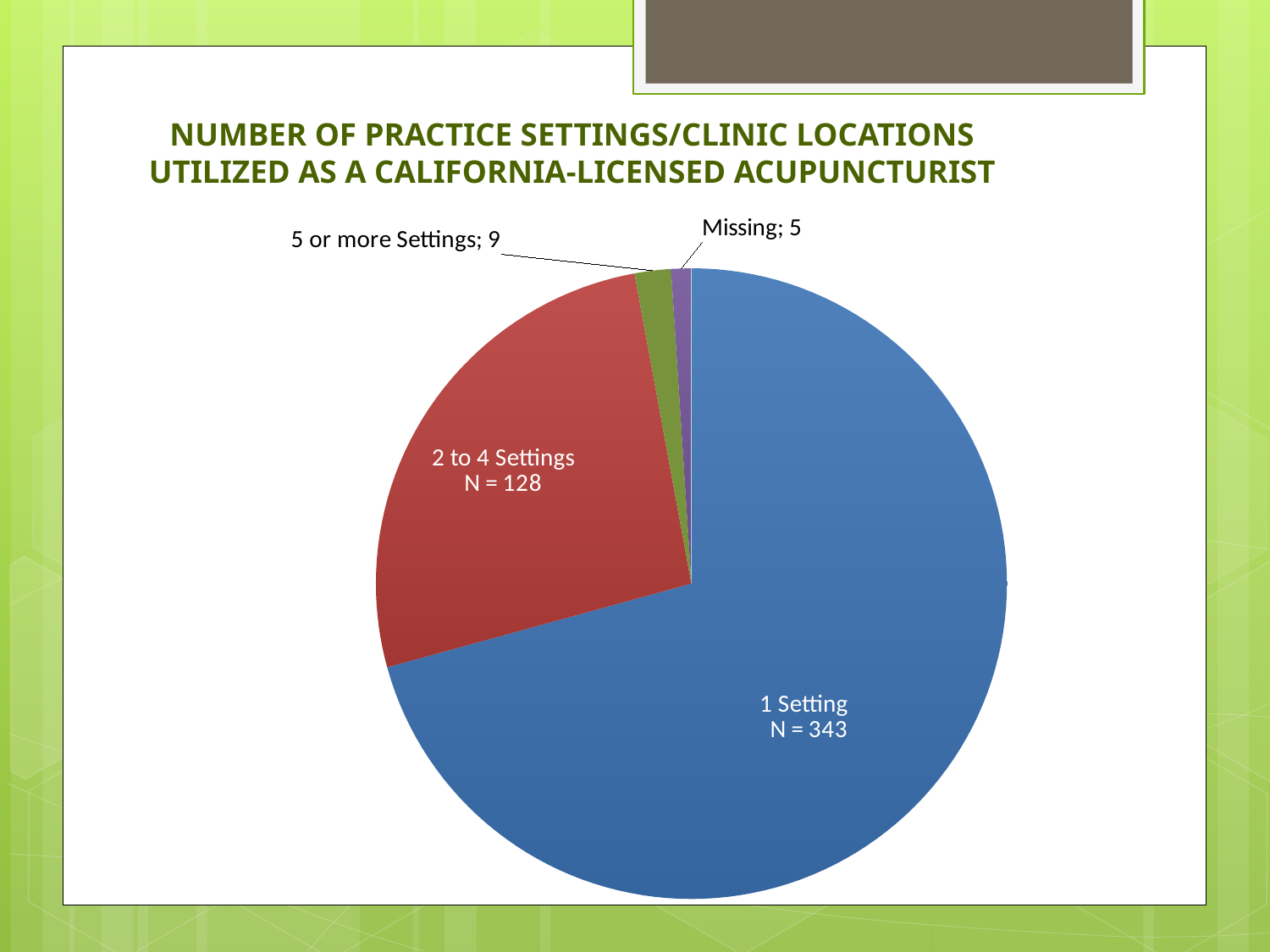
What is the title of the chart? NUMBER OF PRACTICE SETTINGS/CLINIC LOCATIONS UTILIZED AS A CALIFORNIA-LICENSED ACUPUNCTURIST Which is larger, the value for "5 or more Settings" or the value for "Missing"? 5 or more Settings How many slices does the pie chart have? 4 What is the value for the "Missing" slice? 5 What is the total of all four slices in the pie chart? 485 Which category has the largest slice of the pie? 1 Setting What is the difference between the values for "1 Setting" and "2 to 4 Settings"? 215 What kind of chart is shown on the slide? Pie chart What is the value for the "2 to 4 Settings" slice? N = 128 What is the value for the "1 Setting" slice? N = 343 What is the value for the "5 or more Settings" slice? 9 Which category has the smallest slice of the pie? Missing